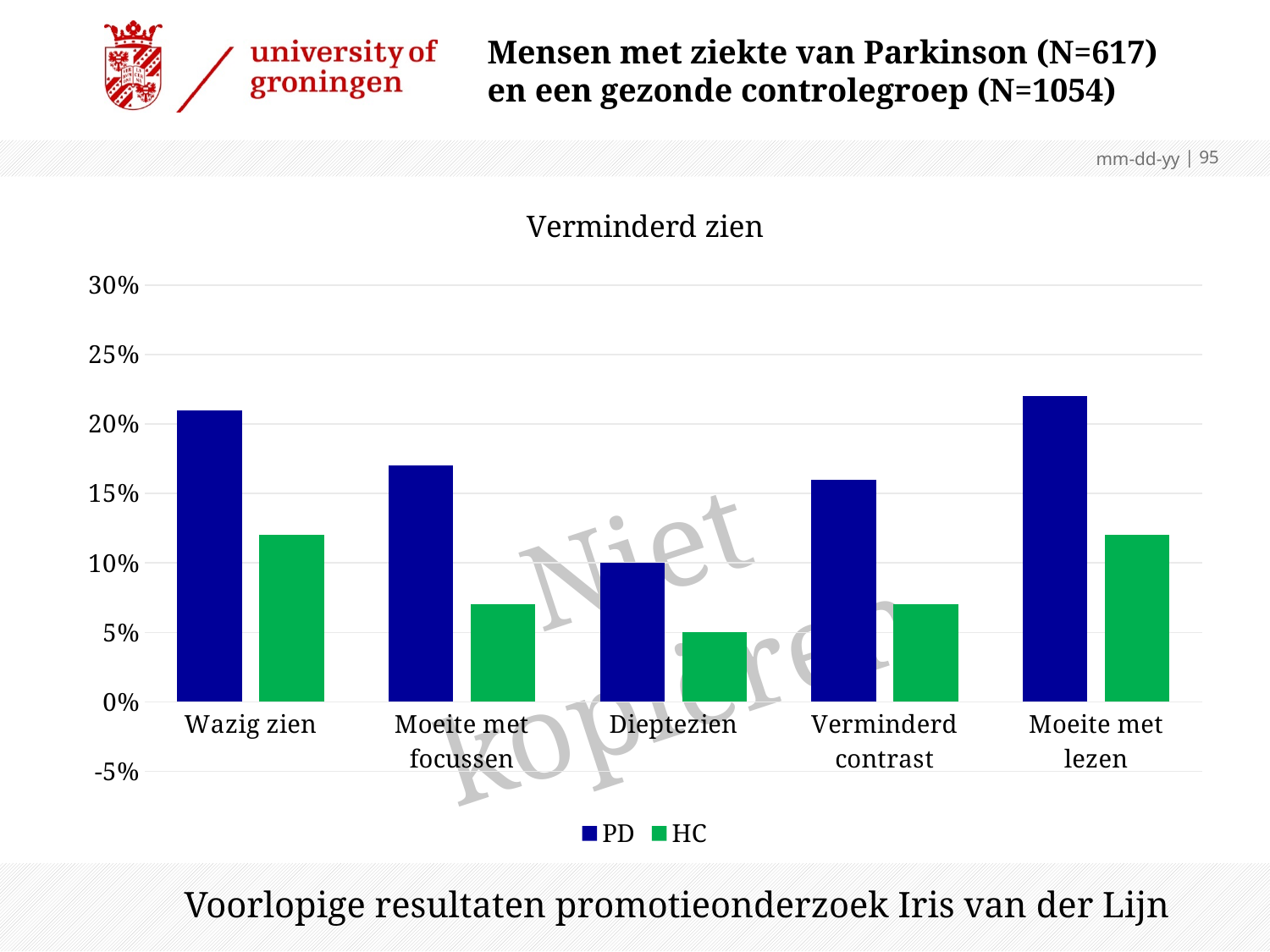
Is the HC value for Moeite met focussen greater or less than 10%? less How many categories are shown on the x axis? 5 Is the PD value for Moeite met lezen greater or less than 25%? less What is the title of the chart? Verminderd zien How many series does the legend list? 2 What type of chart is shown on the slide? bar chart Which category has the lowest HC value? Dieptezien For Verminderd contrast, which series has the larger value, PD or HC? PD Is the HC value for Wazig zien greater or less than 10%? greater Which category has the lowest PD value? Dieptezien Which series is shown in green in the legend? HC